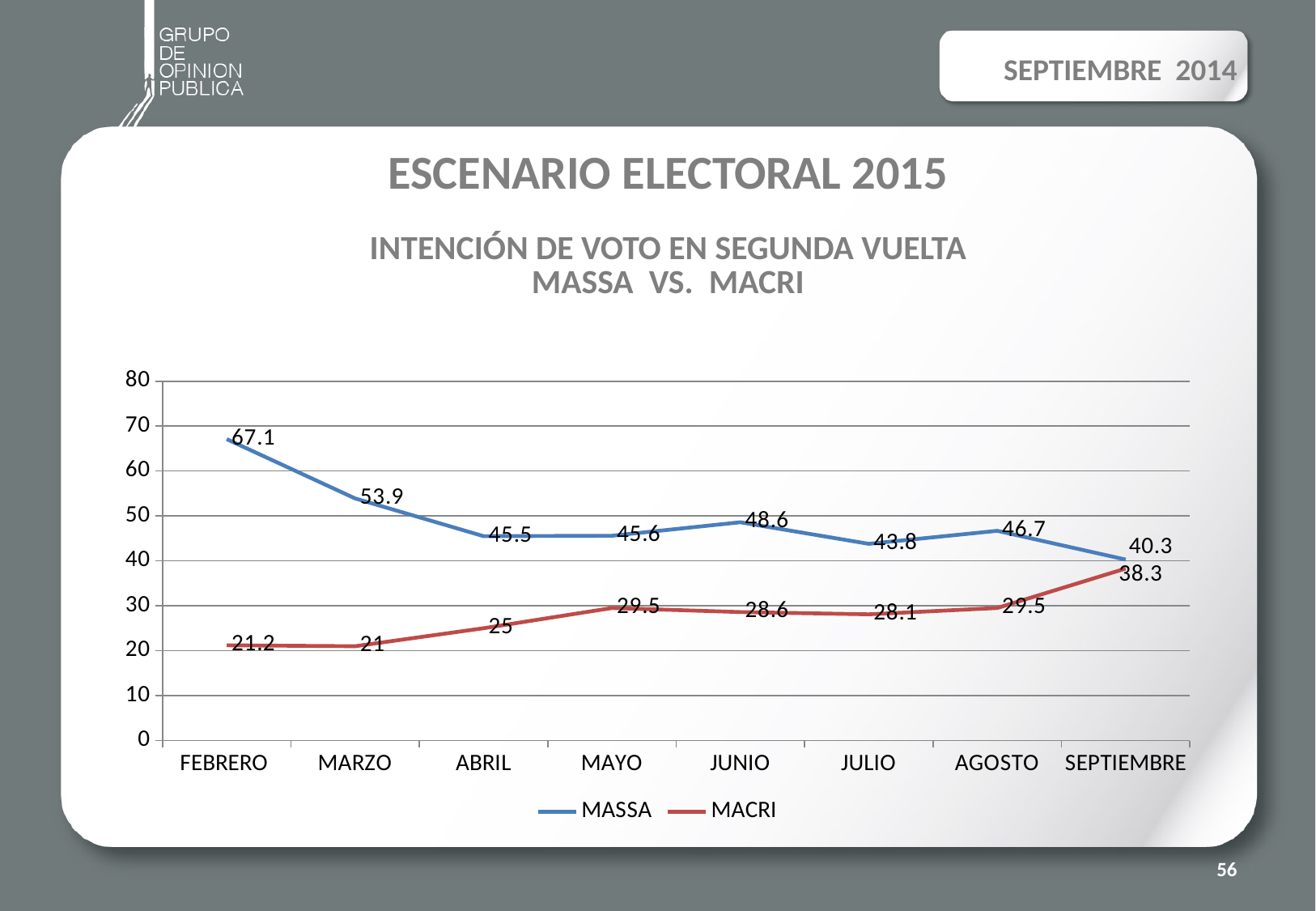
What is the value for MACRI in ABRIL? 25 Does the MACRI series generally rise or fall from FEBRERO to SEPTIEMBRE? Rise What is the difference between the MASSA values in FEBRERO and MARZO? 13.2 Which is larger, the MASSA value in JUNIO or the MASSA value in AGOSTO? JUNIO What is the value for MASSA in FEBRERO? 67.1 In which month is the MACRI series lowest? MARZO How many months are plotted on the x axis? 8 What is the difference between MASSA and MACRI in SEPTIEMBRE? 2 What kind of chart is shown on the slide? Line chart In which month is the MASSA series highest? FEBRERO How many series does the legend list? 2 What is the value for MACRI in SEPTIEMBRE? 38.3